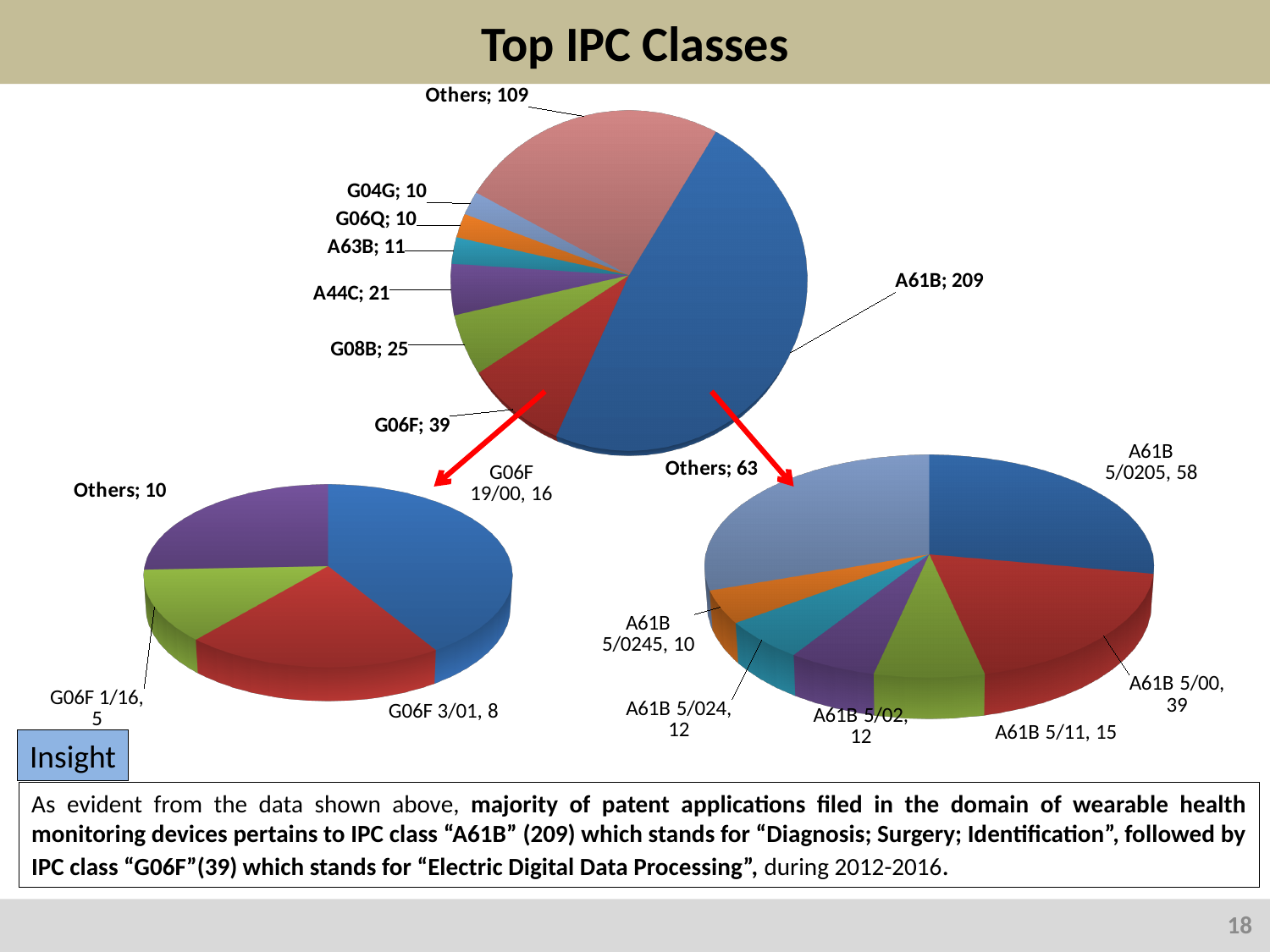
In the bottom-right pie chart, what is the value for A61B 5/0205? 58 In the bottom-left pie chart, what is the value for G06F 19/00? 16 In the top pie chart, what is the difference between the values for A61B and G06F? 170 In the top pie chart, what is the value for G08B? 25 In the top pie chart, how many slices are there? 8 In the bottom-right pie chart, what is the difference between the values for A61B 5/00 and A61B 5/11? 24 In the top pie chart, which IPC class has the largest value? A61B In the bottom-left pie chart, which category has the smallest value? G06F 1/16 What kind of chart is used on this slide? Pie chart In the bottom-left pie chart, what is the total of all slices? 39 In the top pie chart, what is the value for A61B? 209 In the top pie chart, which is larger, the value for A44C or the value for A63B? A44C